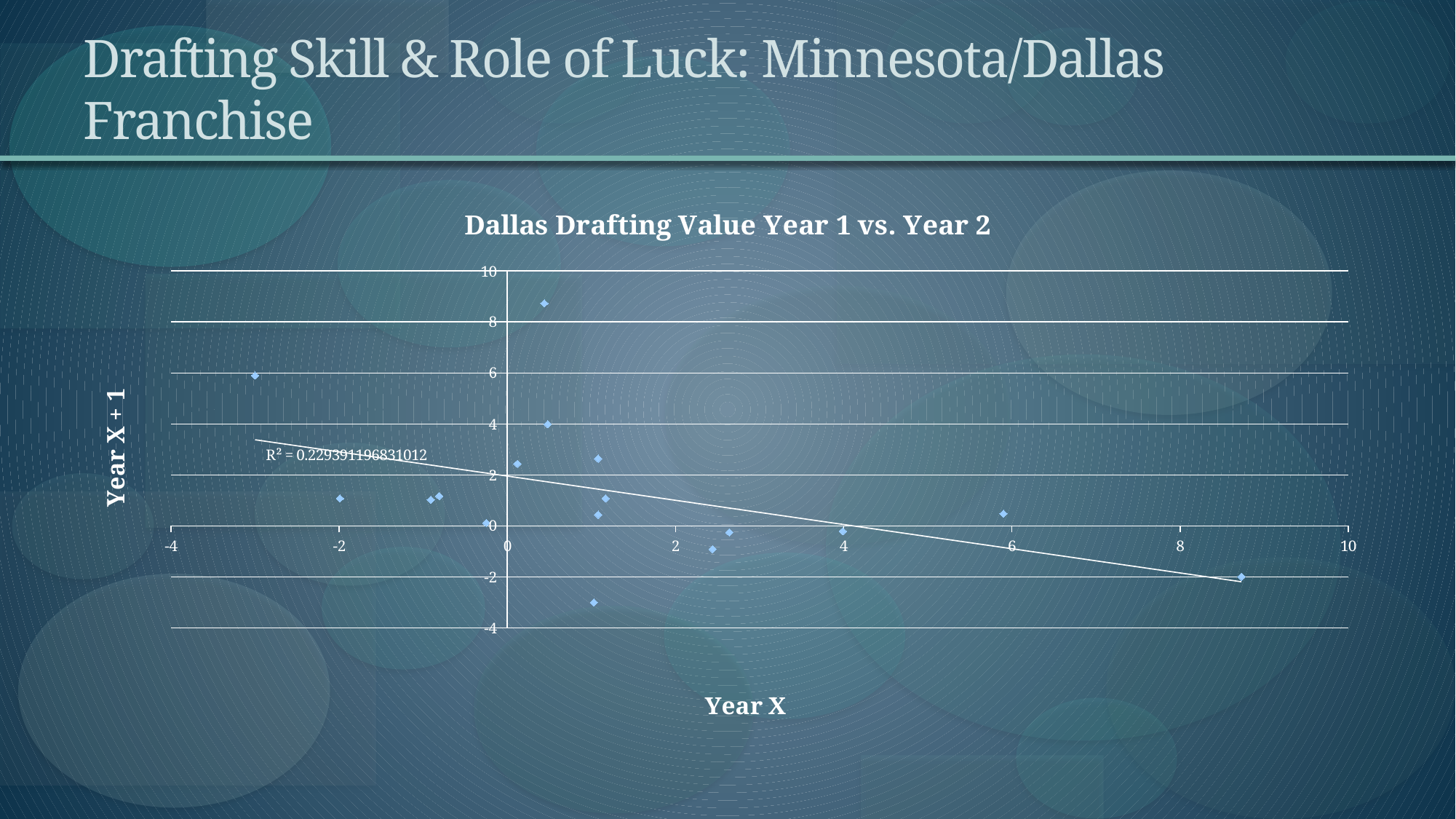
Is the Year X value of the leftmost point greater or less than -2? less What is the title of the chart? Dallas Drafting Value Year 1 vs. Year 2 What is the label of the horizontal axis? Year X What is the minimum value shown on the horizontal axis? -4 What is the maximum value shown on the vertical axis? 10 Is the Year X value of the rightmost point greater or less than 8? greater Is the highest plotted Year X + 1 value greater or less than 8? greater What R² value is printed on the chart? R² = 0.229391196831012 Does the trendline rise or fall as Year X increases? Falls What kind of chart is shown on the slide? Scatter chart